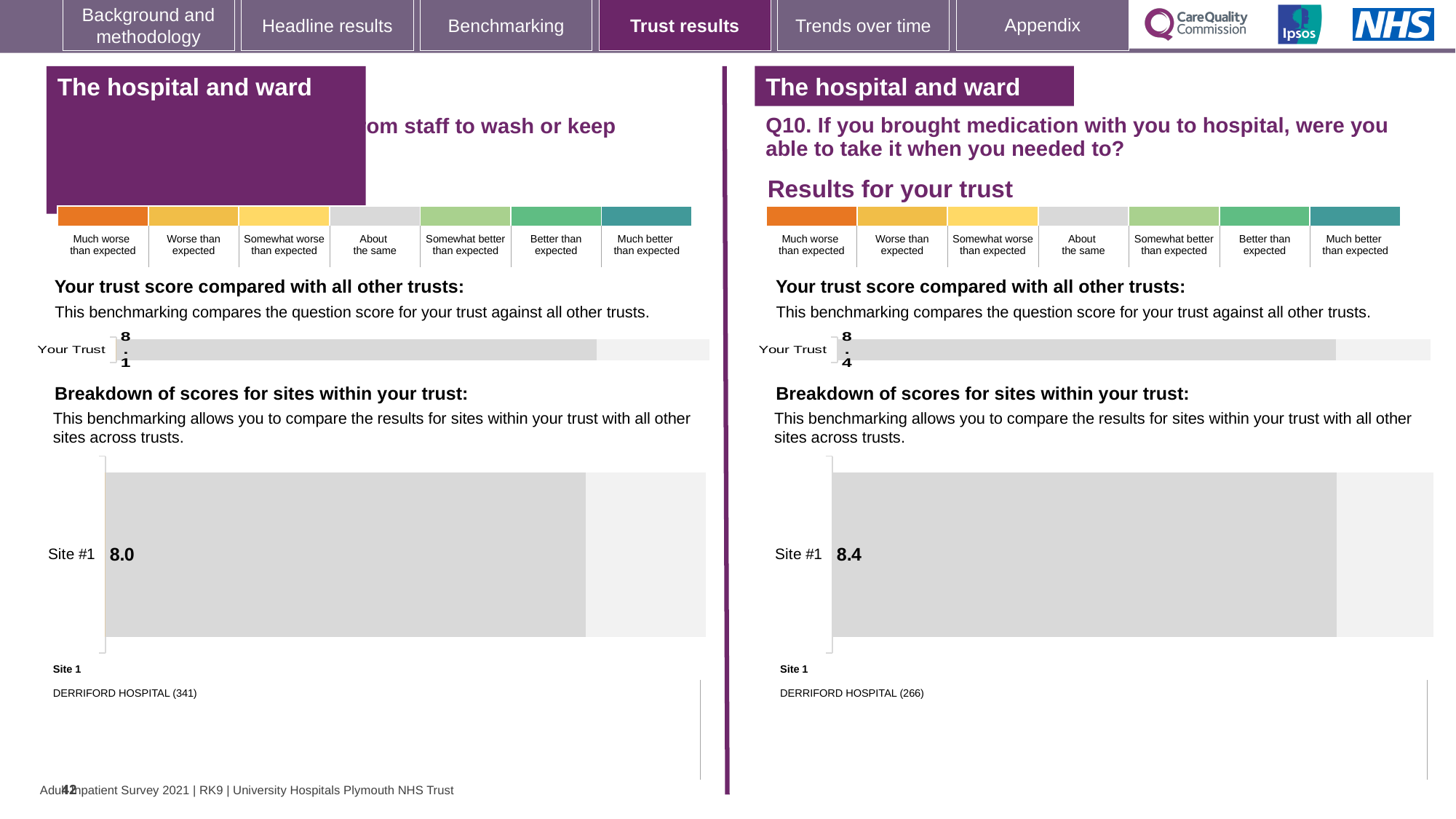
What is the difference between the Your Trust score on the right half (Q10) and the Your Trust score on the left half of the slide? 0.3 On the right half of the slide (Q10), what is the score shown for Site #1 in the 'Breakdown of scores for sites within your trust' chart? 8.4 How many sites are plotted in the 'Breakdown of scores for sites within your trust' chart on the right half of the slide (Q10)? 1 On the left half of the slide, what is the score shown for Site #1 in the 'Breakdown of scores for sites within your trust' chart? 8.0 On the right half of the slide (Q10), what is the score shown for Your Trust in the 'Your trust score compared with all other trusts' chart? 8.4 On the left half of the slide, what is the difference between the Your Trust score and the Site #1 score? 0.1 Which hospital is listed as Site 1 beneath the breakdown chart on the right half of the slide (Q10)? DERRIFORD HOSPITAL (266) Which hospital is listed as Site 1 beneath the breakdown chart on the left half of the slide? DERRIFORD HOSPITAL (341) On the left half of the slide, what is the score shown for Your Trust in the 'Your trust score compared with all other trusts' chart? 8.1 What kind of chart is used to show the Site #1 score in the 'Breakdown of scores for sites within your trust' section? Bar chart What is the difference between the Site #1 score on the right half (Q10) and the Site #1 score on the left half of the slide? 0.4 Which is larger: the Site #1 score in the left-hand breakdown chart or the Site #1 score in the right-hand (Q10) breakdown chart? The right-hand (Q10) Site #1 score